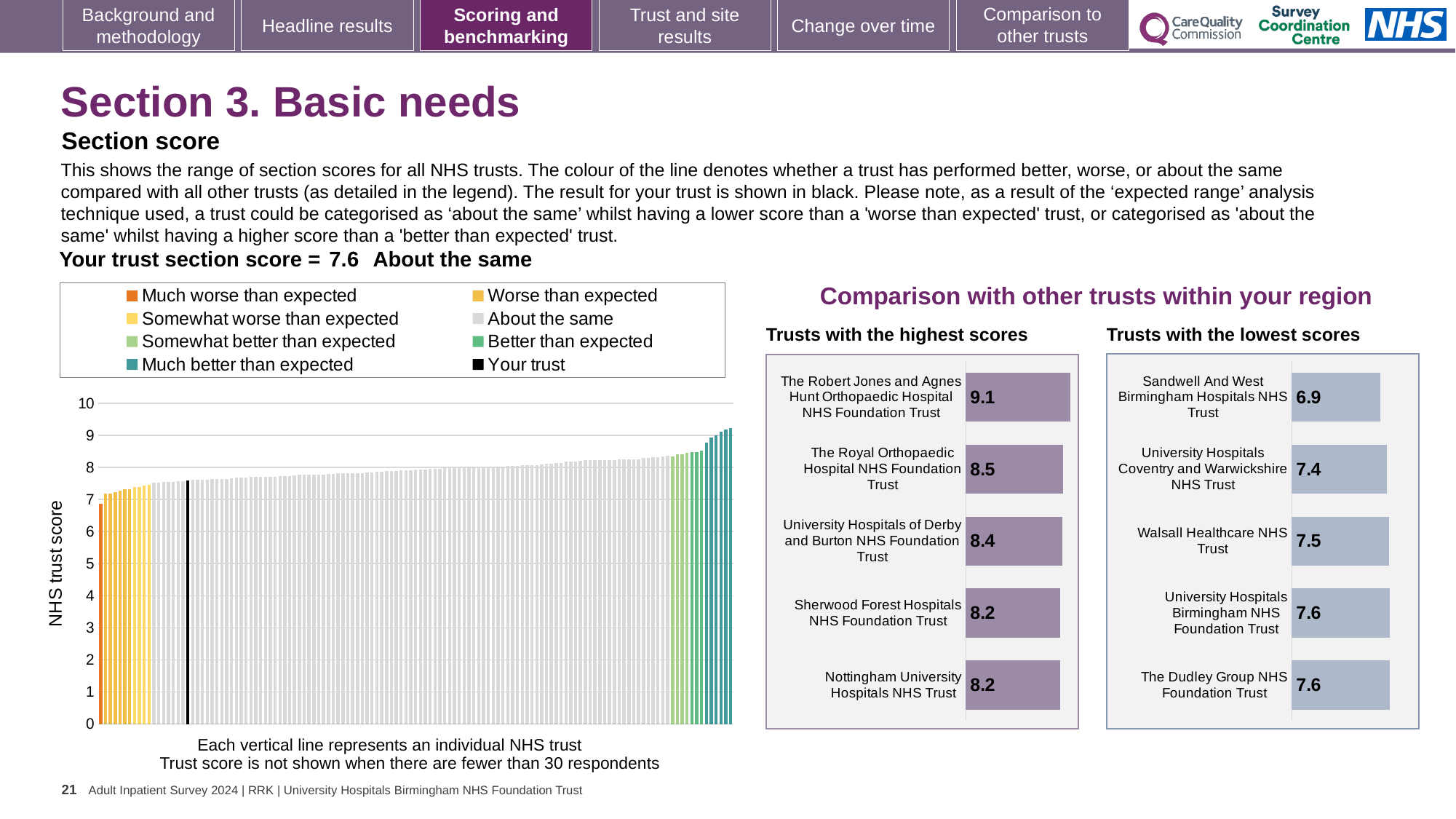
How many entries does the legend of the large chart on the left list? 8 In the 'Trusts with the lowest scores' chart, what is the difference between the scores of The Dudley Group NHS Foundation Trust and Sandwell And West Birmingham Hospitals NHS Trust? 0.7 In the 'Trusts with the highest scores' chart, which trust has the highest score? The Robert Jones and Agnes Hunt Orthopaedic Hospital NHS Foundation Trust What kind of chart is the 'Trusts with the lowest scores' chart? Bar chart In the 'Trusts with the lowest scores' chart, what is the score for Sandwell And West Birmingham Hospitals NHS Trust? 6.9 In the 'Trusts with the highest scores' chart, what is the score for The Robert Jones and Agnes Hunt Orthopaedic Hospital NHS Foundation Trust? 9.1 In the large chart on the left showing all NHS trusts, do the values rise or fall from left to right along the x axis? Rise In the 'Trusts with the highest scores' chart, what is the difference between the scores of The Robert Jones and Agnes Hunt Orthopaedic Hospital NHS Foundation Trust and The Royal Orthopaedic Hospital NHS Foundation Trust? 0.6 How many trusts are shown in the 'Trusts with the highest scores' chart? 5 In the 'Trusts with the highest scores' chart, which has the larger score: University Hospitals of Derby and Burton NHS Foundation Trust or Sherwood Forest Hospitals NHS Foundation Trust? University Hospitals of Derby and Burton NHS Foundation Trust In the 'Trusts with the lowest scores' chart, which trust has the lowest score? Sandwell And West Birmingham Hospitals NHS Trust In the 'Trusts with the lowest scores' chart, what is the score for Walsall Healthcare NHS Trust? 7.5